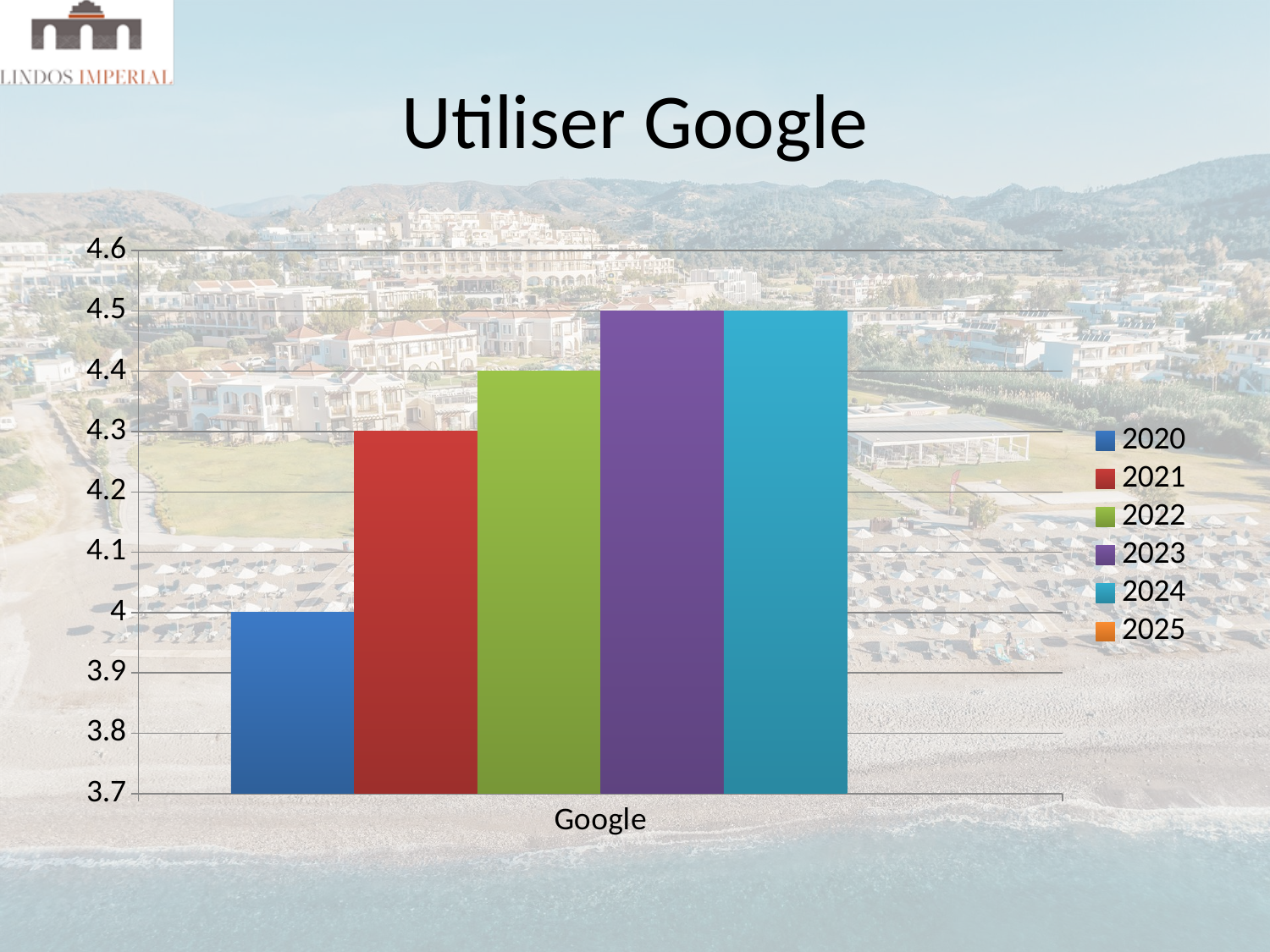
What is the difference between the values for 2024 and 2020? 0.5 How many series does the legend list? 6 What is the value for 2023 in the Google chart? 4.5 What is the title of the slide containing the chart? Utiliser Google What type of chart is shown on the slide? bar chart What is the value for 2020 in the Google chart? 4 What is the value for 2022 in the Google chart? 4.4 Which is larger, the value for 2021 or the value for 2022? 2022 What is the value for 2021 in the Google chart? 4.3 Do the values rise or fall from 2020 to 2023? rise What is the value for 2024 in the Google chart? 4.5 Which year has the lowest value in the chart? 2020